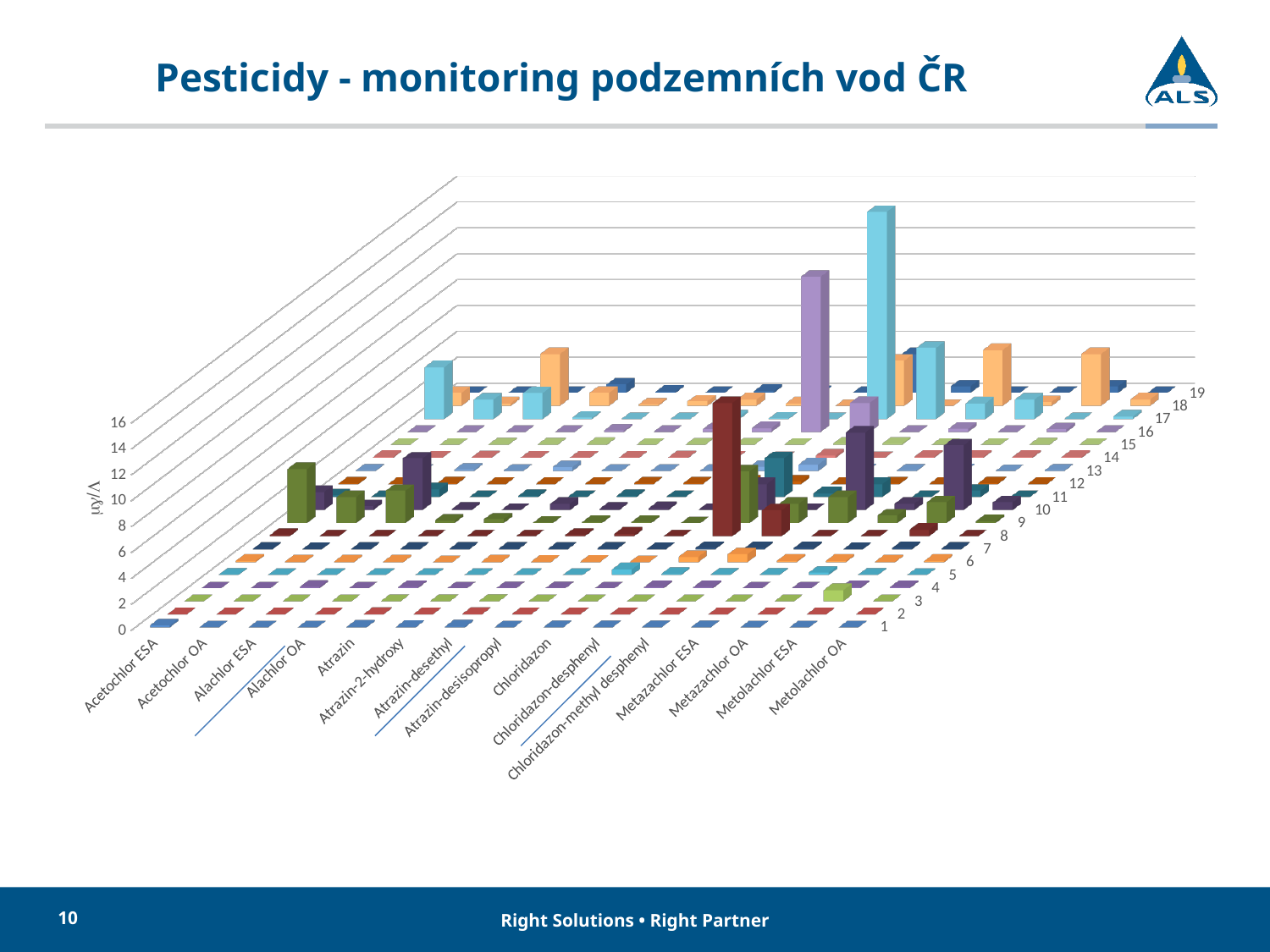
What is the title of the slide containing the chart? Pesticidy - monitoring podzemních vod ČR What kind of chart is shown on the slide? bar chart What is the label on the vertical axis of the chart? µg/l What is the last category labelled on the x axis of the chart? Metolachlor OA How many numbered rows (1 to 19) are shown along the depth axis of the chart? 19 What is the highest tick value shown on the vertical axis of the chart? 16 What is the first category labelled on the x axis of the chart? Acetochlor ESA How many pesticide categories are labelled along the x axis of the chart? 15